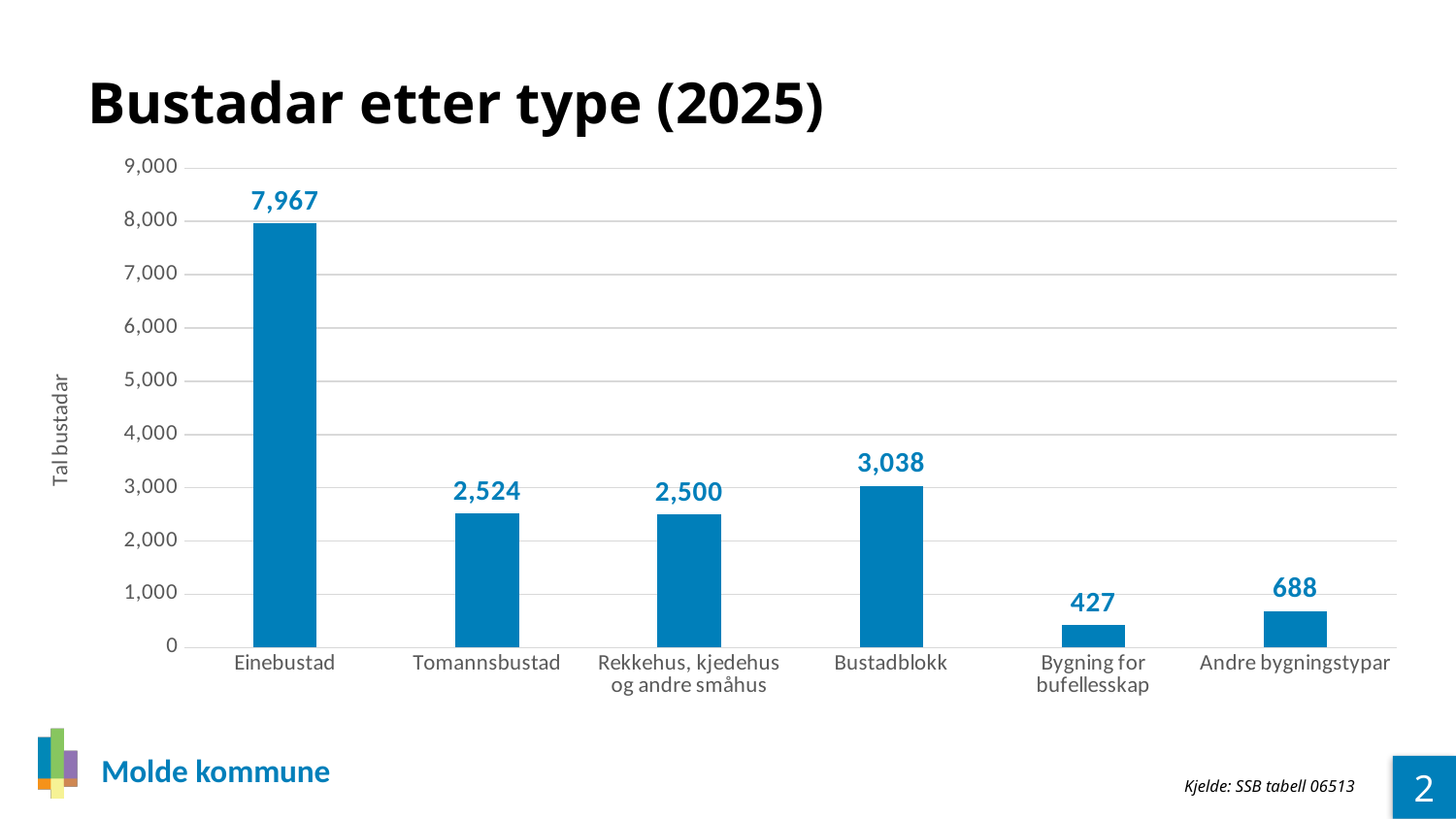
What is the value for Bustadblokk? 3,038 What is the value for Bygning for bufellesskap? 427 Which is larger, Bustadblokk or Tomannsbustad? Bustadblokk What is the difference between Einebustad and Bustadblokk? 4,929 Is the value for Andre bygningstypar greater or less than 1,000? less How many categories are shown on the x axis? 6 What is the title of the chart? Bustadar etter type (2025) What kind of chart is this? bar chart Which category has the highest value? Einebustad What is the value for Einebustad? 7,967 What is the difference between Tomannsbustad and Rekkehus, kjedehus og andre småhus? 24 Which category has the lowest value? Bygning for bufellesskap